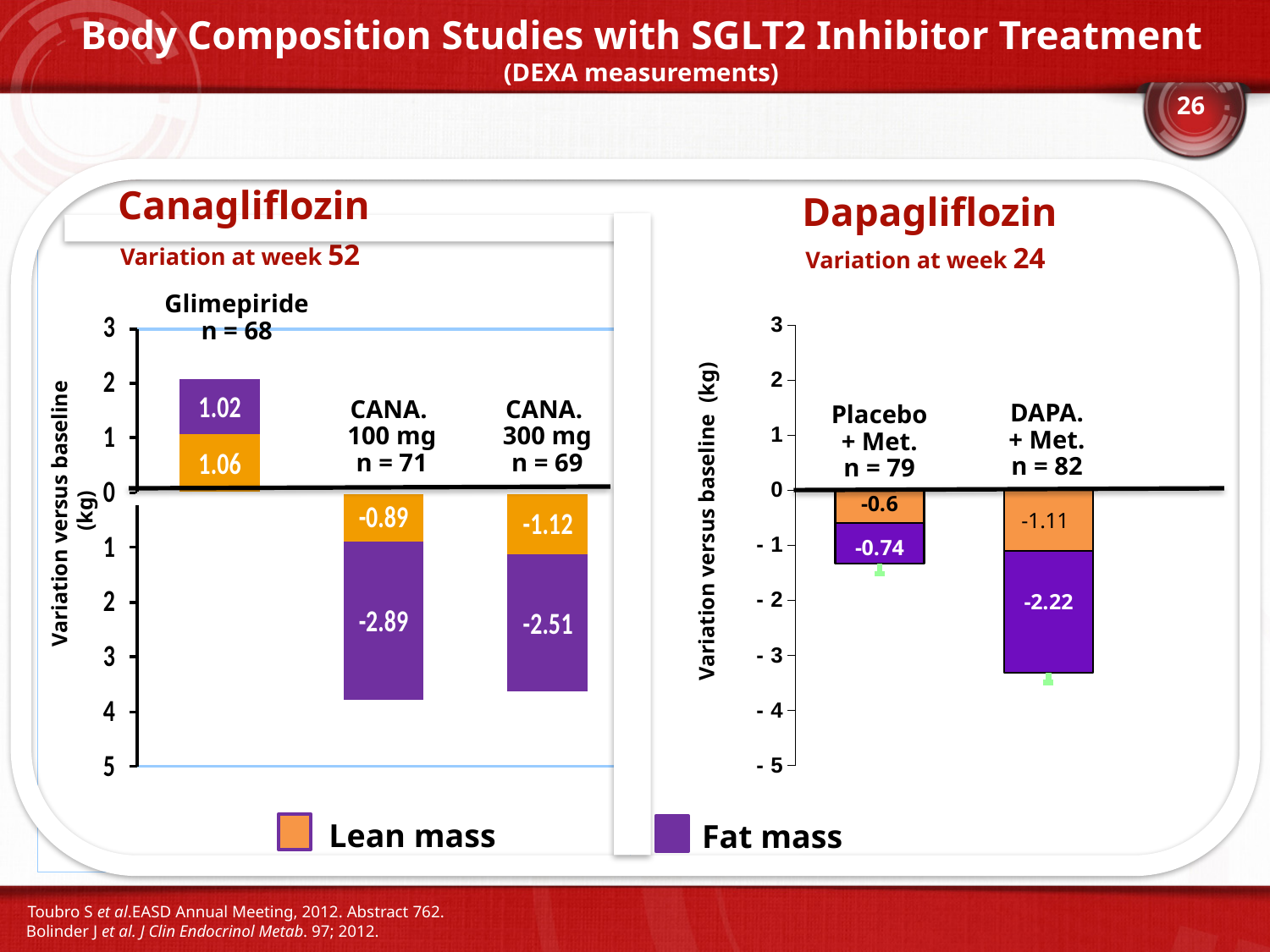
In the Canagliflozin chart, what is the total variation (lean plus fat mass) for CANA. 100 mg? -3.78 In the Canagliflozin chart, what is the difference between the fat mass variation for CANA. 100 mg and CANA. 300 mg? 0.38 In the Dapagliflozin chart, which group has the larger fat mass loss, Placebo + Met. or DAPA. + Met.? DAPA. + Met. In the Canagliflozin chart, what is the lean mass variation for CANA. 300 mg? -1.12 In the Dapagliflozin chart, what is the lean mass variation for Placebo + Met.? -0.6 In the Dapagliflozin chart, what is the total variation (lean plus fat mass) for DAPA. + Met.? -3.33 In the Canagliflozin chart, what is the lean mass variation for Glimepiride? 1.06 How many treatment groups are shown in the Canagliflozin chart? 3 In the Canagliflozin chart, what is the fat mass variation for CANA. 100 mg? -2.89 How many series does the legend list? 2 What kind of chart is the Dapagliflozin chart? Stacked bar chart In the Dapagliflozin chart, what is the fat mass variation for DAPA. + Met.? -2.22